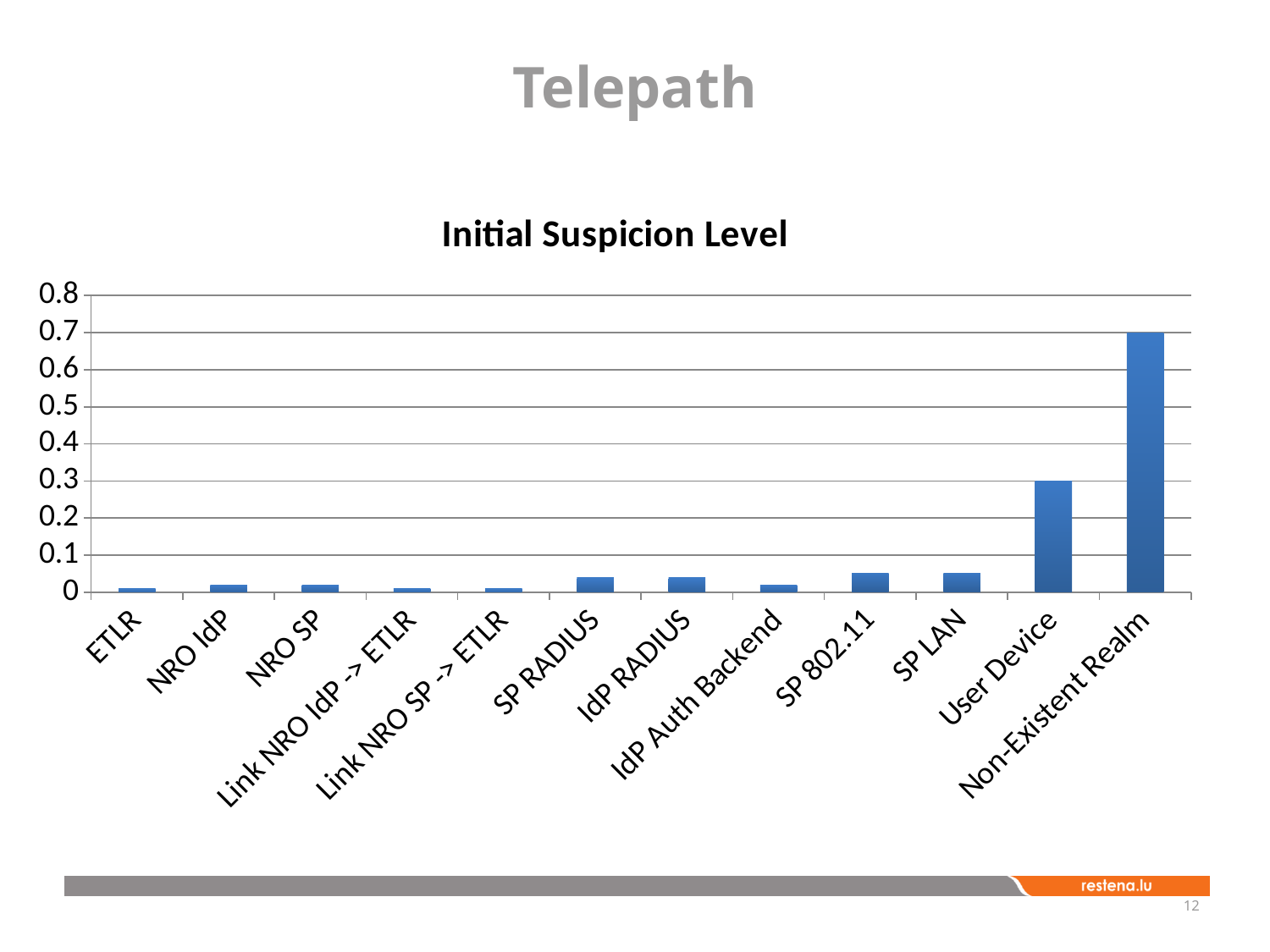
What type of chart is shown on the slide? bar chart Which is larger, the value for User Device or the value for SP LAN? User Device Is the value for Non-Existent Realm greater or less than 0.6? greater How many categories are plotted on the x axis? 12 Which is larger, the value for Non-Existent Realm or the value for IdP Auth Backend? Non-Existent Realm What is the initial suspicion level for User Device? 0.3 Is the value for SP RADIUS greater or less than 0.1? less What is the initial suspicion level for Non-Existent Realm? 0.7 Which category has the highest initial suspicion level? Non-Existent Realm Is the value for User Device greater or less than 0.2? greater What is the difference between the values for Non-Existent Realm and User Device? 0.4 What is the title of the chart? Initial Suspicion Level